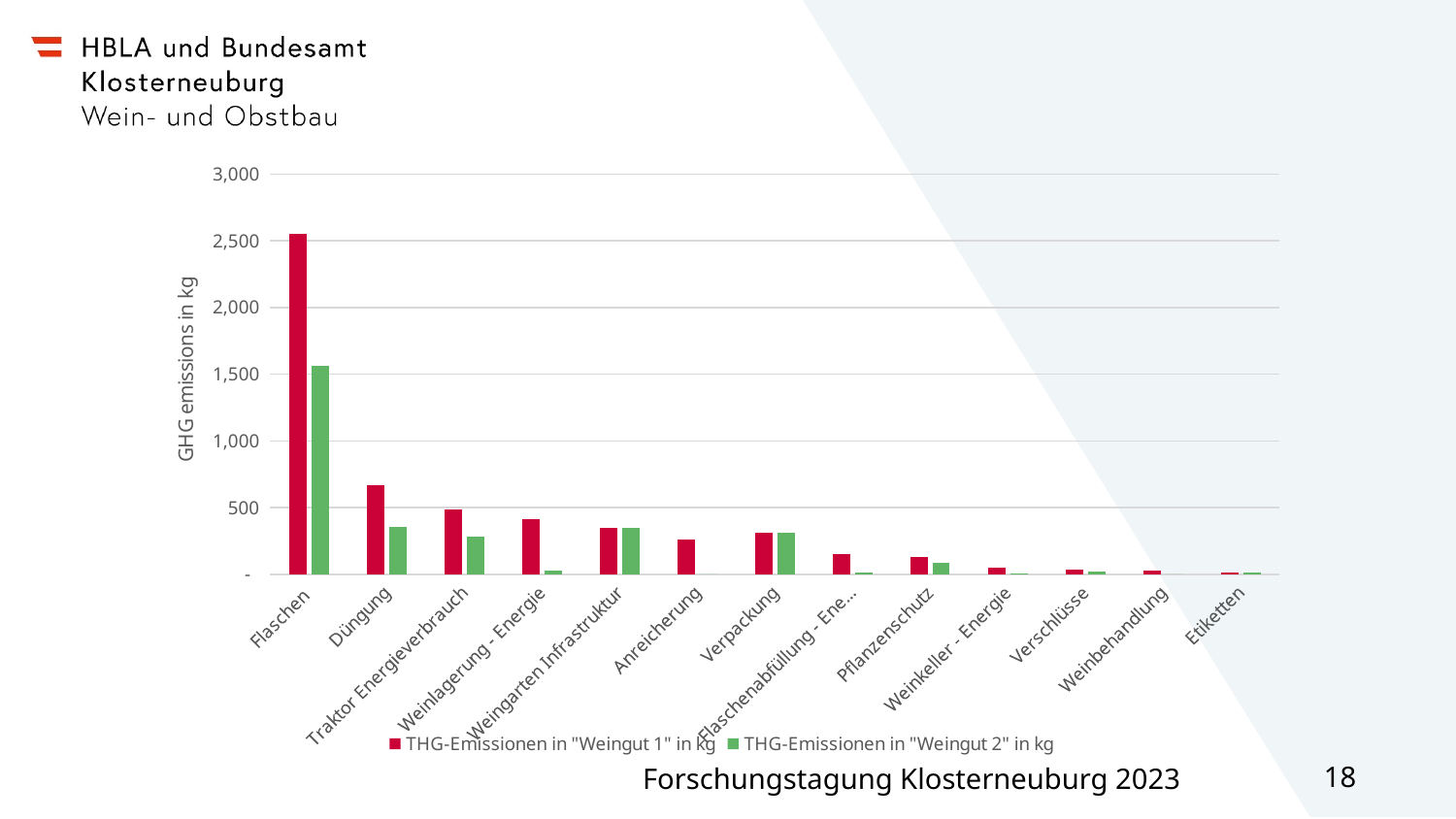
For Düngung, which is larger: the value for "Weingut 1" or for "Weingut 2"? Weingut 1 Which category has the highest value for THG-Emissionen in "Weingut 1" in kg? Flaschen What kind of chart is shown on the slide? bar chart How many categories are shown on the x axis? 13 What is the label of the vertical axis? GHG emissions in kg Is the value for Flaschen in "Weingut 2" greater or less than 1,000? greater Do the values for THG-Emissionen in "Weingut 1" rise or fall from left to right along the x axis? fall Is the value for Düngung in "Weingut 1" greater or less than 500? greater How many series does the legend list? 2 Which category has the highest value for THG-Emissionen in "Weingut 2" in kg? Flaschen Is the value for Anreicherung in "Weingut 1" greater or less than 500? less